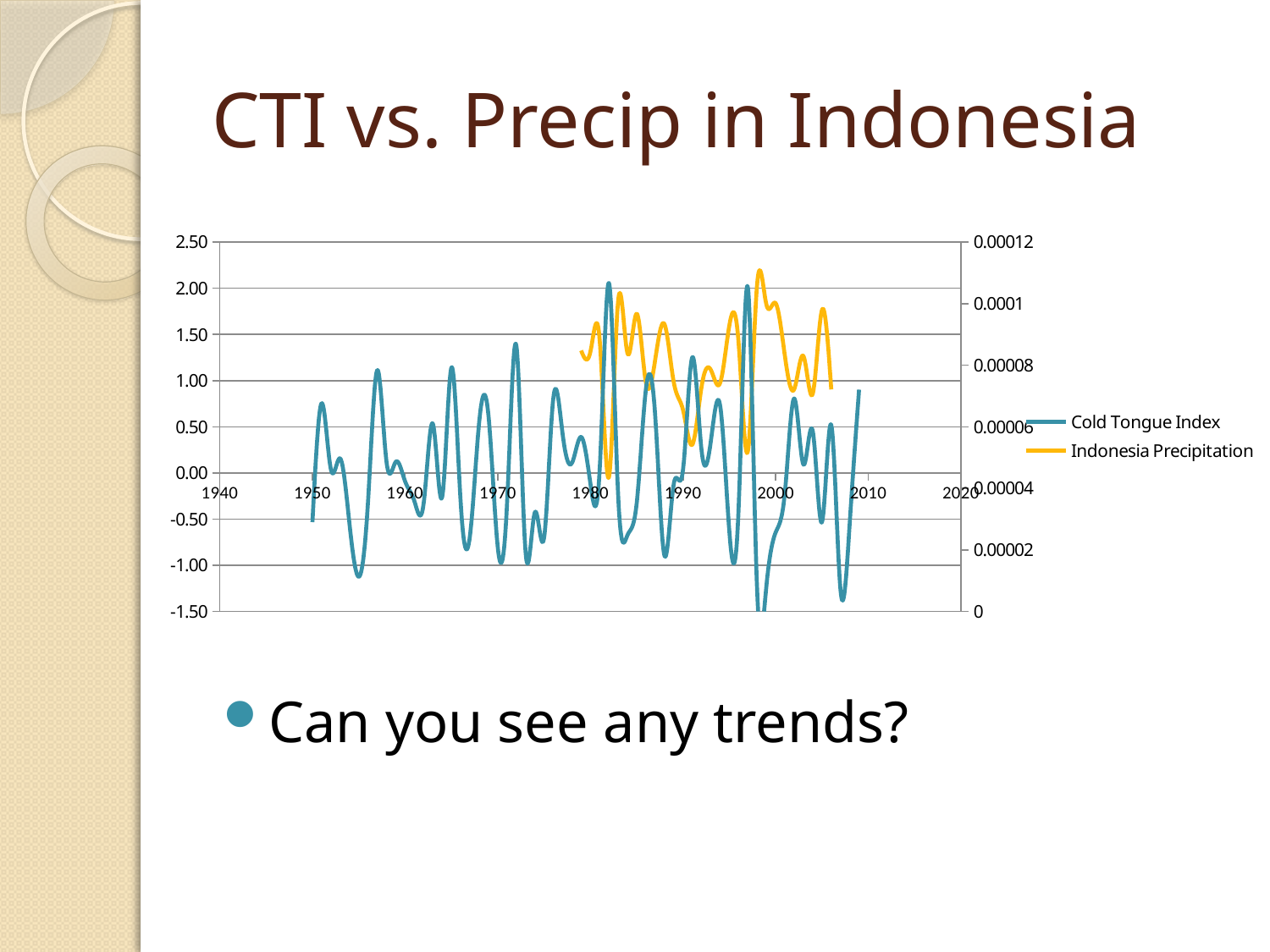
What are the two series named in the legend? Cold Tongue Index and Indonesia Precipitation Is the lowest value of the Cold Tongue Index around 1998 greater or less than -1.00? less Is the peak value of the Cold Tongue Index around 1982 greater or less than 1.50? greater Is the Cold Tongue Index value around 1955 greater or less than -0.50? less What kind of chart is shown on the slide? Line chart What is the maximum value shown on the right vertical axis? 0.00012 What is the maximum value shown on the left vertical axis? 2.50 Which series begins earlier on the x axis, Cold Tongue Index or Indonesia Precipitation? Cold Tongue Index How many series does the legend list? 2